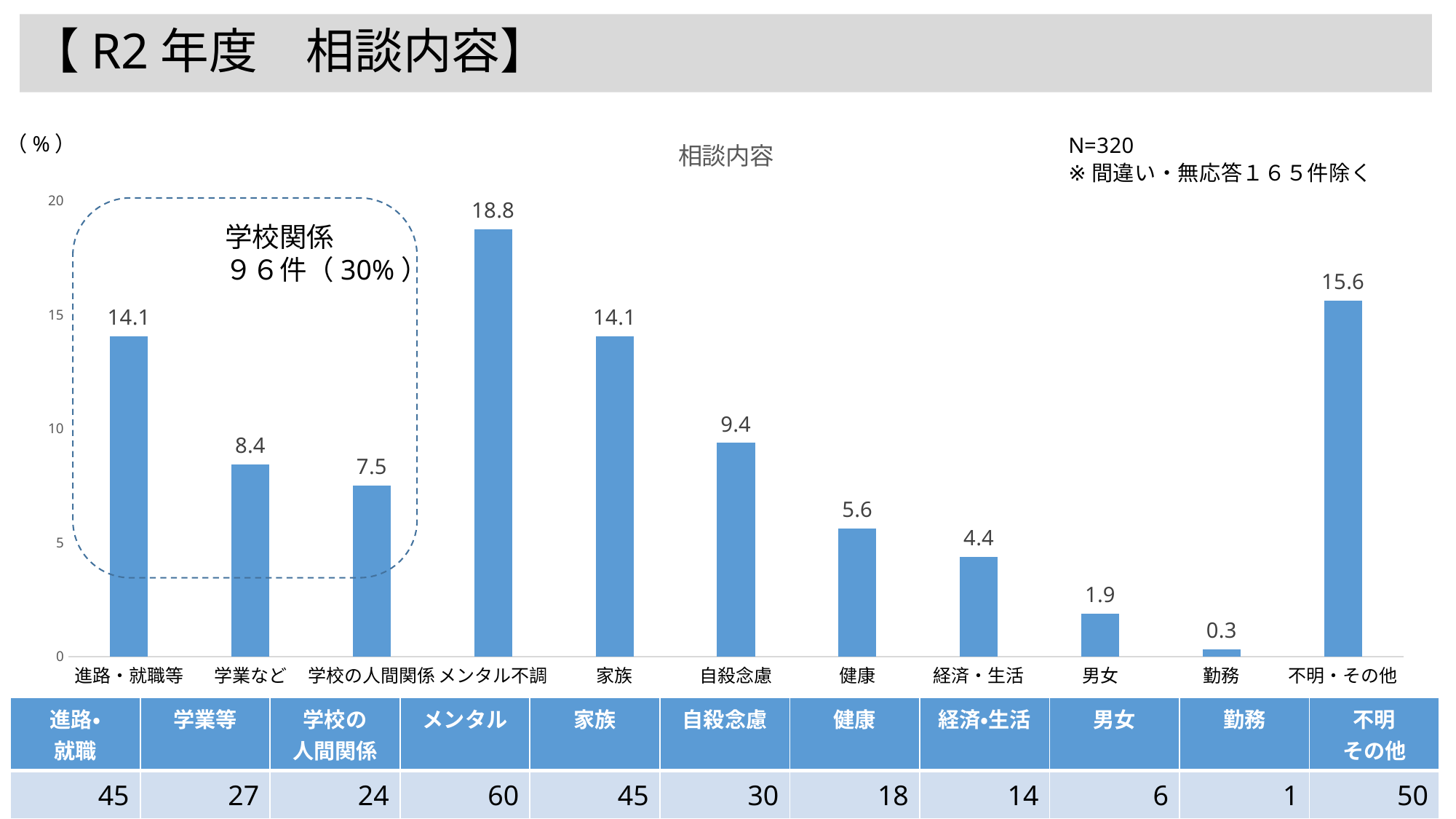
What is the difference between the values for 学業など and 学校の人間関係 in the 相談内容 chart? 0.9 What is the value for 自殺念慮 in the 相談内容 chart? 9.4 Which category has the lowest value in the 相談内容 chart? 勤務 What is the value for 不明・その他 in the 相談内容 chart? 15.6 What is the title of the chart on the slide? 相談内容 What is the difference between the values for メンタル不調 and 不明・その他 in the 相談内容 chart? 3.2 How many categories are shown in the 相談内容 chart? 11 Which category has the highest value in the 相談内容 chart? メンタル不調 What is the value for メンタル不調 in the 相談内容 chart? 18.8 What kind of chart is the 相談内容 chart? bar chart Is the value for 家族 in the 相談内容 chart greater or less than 10? greater Which is larger in the 相談内容 chart, the value for 健康 or the value for 経済・生活? 健康